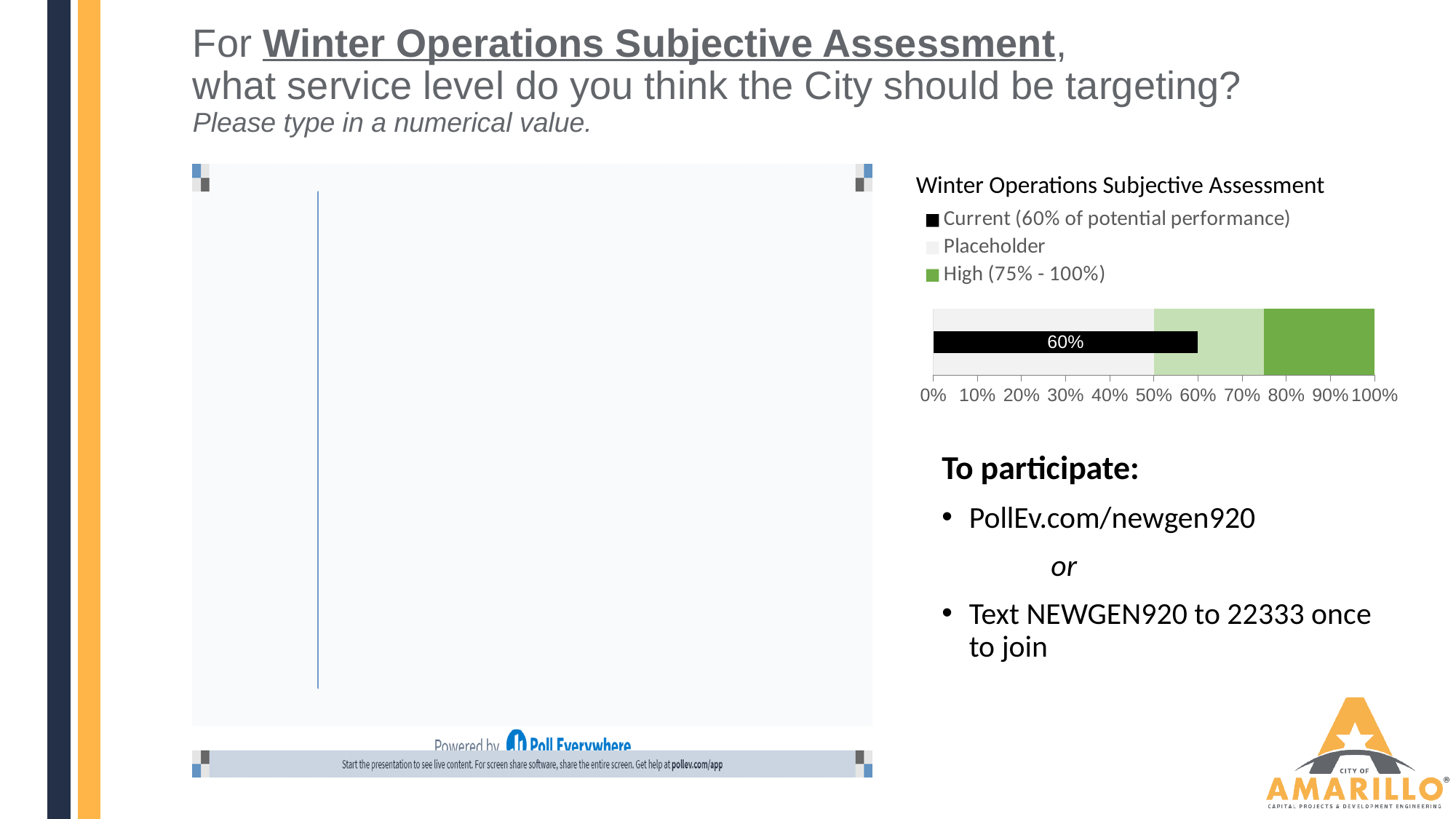
Is the value of the black Current bar in the Winter Operations Subjective Assessment chart greater or less than 70%? less What kind of chart is the Winter Operations Subjective Assessment chart? bar chart What is the title of the chart on the slide? Winter Operations Subjective Assessment What is the lowest value shown on the x axis of the Winter Operations Subjective Assessment chart? 0% What value is printed on the black bar in the Winter Operations Subjective Assessment chart? 60% In the Winter Operations Subjective Assessment chart, which legend entry is shown in black? Current (60% of potential performance) What range does the legend give for the High category in the Winter Operations Subjective Assessment chart? 75% - 100% What is the highest value shown on the x axis of the Winter Operations Subjective Assessment chart? 100% Is the value of the black Current bar in the Winter Operations Subjective Assessment chart greater or less than 50%? greater How many entries does the legend of the Winter Operations Subjective Assessment chart list? 3